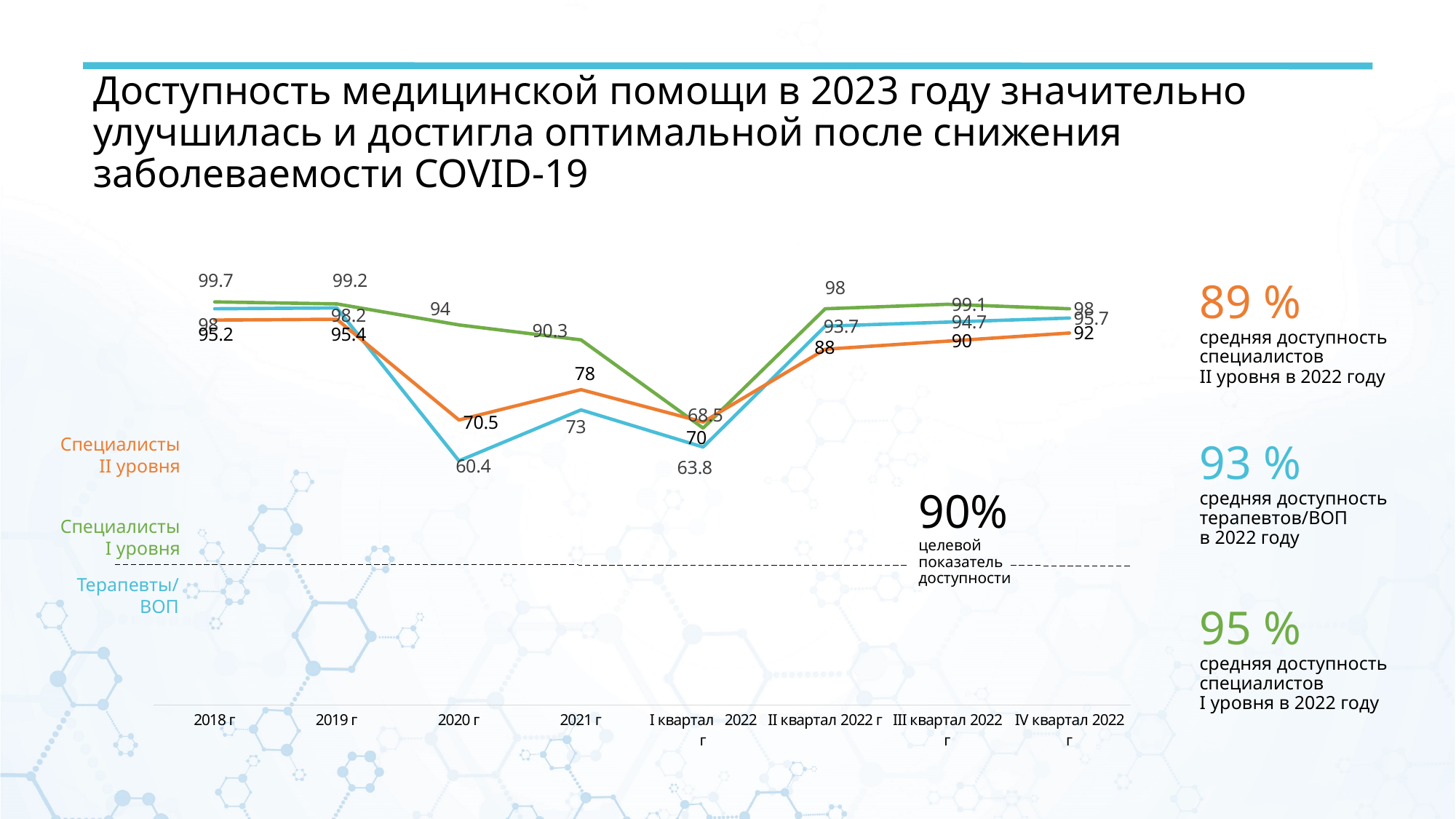
What is the value for Специалисты I уровня in 2018 г? 99.7 How many points are plotted along the x axis of the chart? 8 In 2020 г, which is larger: the value for Специалисты II уровня or for Терапевты/ВОП? Специалисты II уровня What type of chart is shown on the slide? Line chart What is the value for Специалисты II уровня in 2021 г? 78 What target accessibility indicator (целевой показатель доступности) is marked on the chart? 90% How many series does the chart show? 3 In which period is the value for Терапевты/ВОП lowest? 2020 г In which period is the value for Специалисты I уровня highest? 2018 г What is the value for Специалисты I уровня in II квартал 2022 г? 98 What is the value for Терапевты/ВОП in 2020 г? 60.4 What is the difference between the Специалисты I уровня values in 2019 г and 2020 г? 5.2